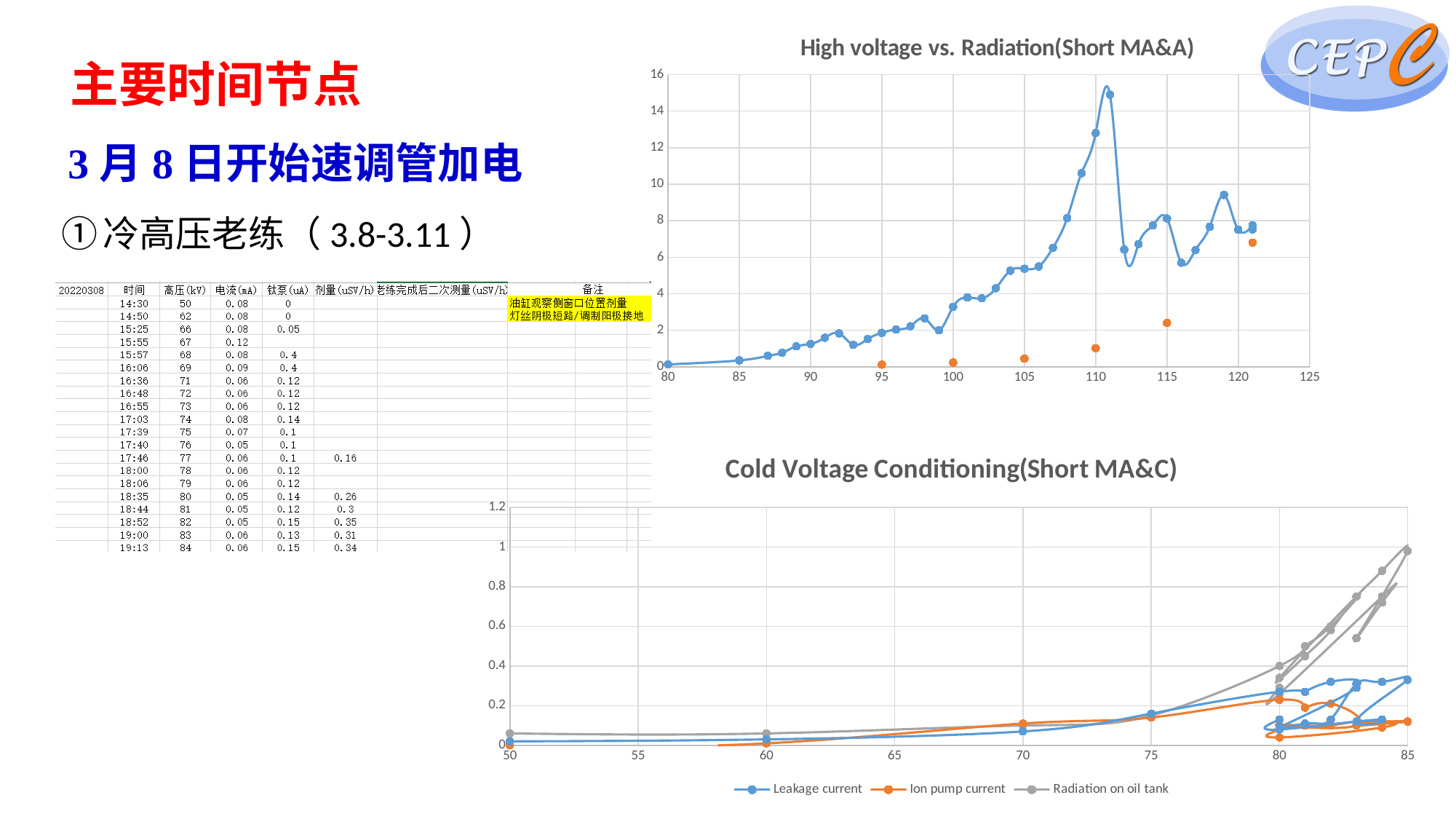
In the 'High voltage vs. Radiation(Short MA&A)' chart, is the peak value of the blue series greater or less than 14? greater What is the title of the top chart on the slide? High voltage vs. Radiation(Short MA&A) In the 'Cold Voltage Conditioning(Short MA&C)' chart, does the 'Radiation on oil tank' series generally rise or fall from x = 50 to x = 85? rise What kind of chart is the 'High voltage vs. Radiation(Short MA&A)' chart? line chart How many series does the legend of the 'Cold Voltage Conditioning(Short MA&C)' chart list? 3 In the 'High voltage vs. Radiation(Short MA&A)' chart, is the orange point near x = 121 greater or less than 8? less In the 'Cold Voltage Conditioning(Short MA&C)' chart, is the highest value of 'Radiation on oil tank' greater or less than 0.8? greater In the 'Cold Voltage Conditioning(Short MA&C)' chart, which series reaches the highest value at x = 85: 'Leakage current' or 'Radiation on oil tank'? Radiation on oil tank What are the legend entries of the 'Cold Voltage Conditioning(Short MA&C)' chart? Leakage current, Ion pump current, Radiation on oil tank